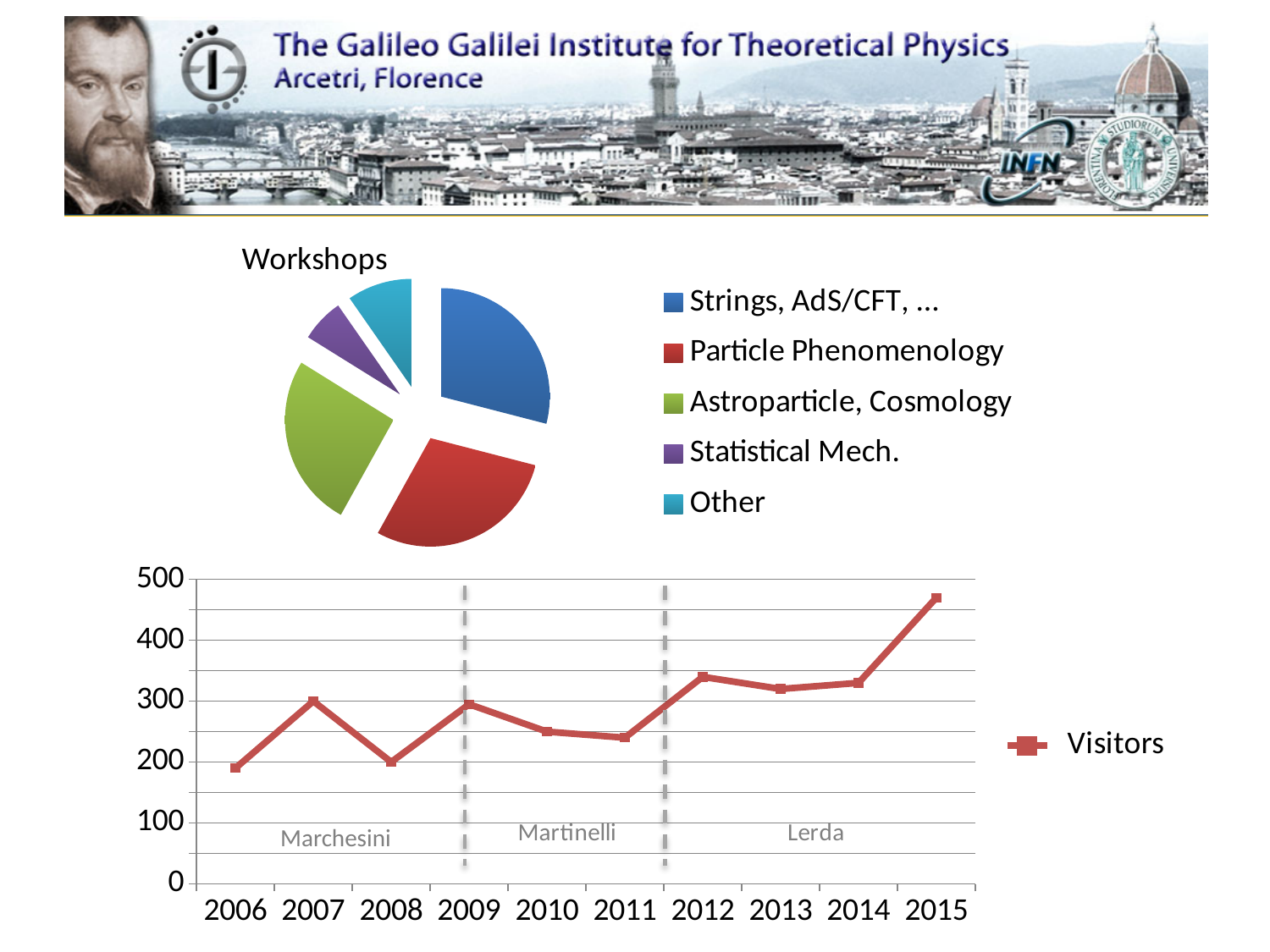
How many series does the legend of the Visitors chart list? 1 In the Visitors chart, do visitors rise or fall from 2014 to 2015? rise How many years are plotted on the x axis of the Visitors chart? 10 In the Visitors chart, which year has the highest number of visitors? 2015 In the Visitors chart, which year has more visitors, 2007 or 2008? 2007 What kind of chart is the Visitors chart at the bottom of the slide? line chart How many categories does the Workshops pie chart show? 5 What kind of chart is the Workshops chart? pie chart In the Visitors chart, is the value for 2011 greater or less than 300? less In the Visitors chart, is the value for 2015 greater or less than 400? greater In the Workshops pie chart, which colour represents Astroparticle, Cosmology? green In the Workshops pie chart, which category has the smallest slice? Statistical Mech.